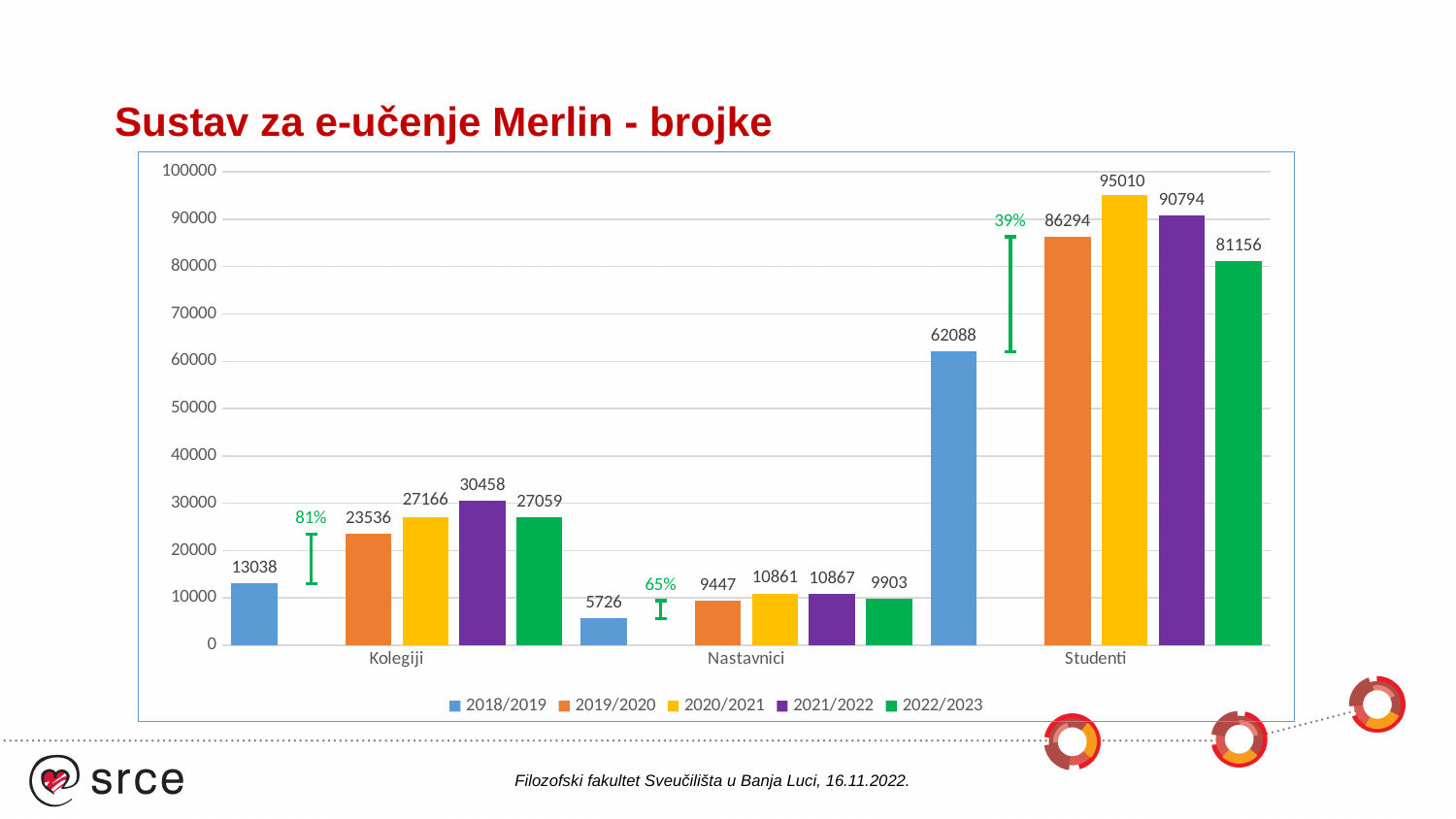
What kind of chart is shown on the slide? bar chart Which series has the highest value for Kolegiji? 2021/2022 Is the 2019/2020 value for Studenti greater or less than 80000? greater Which is larger for Nastavnici: the 2019/2020 value or the 2022/2023 value? 2022/2023 What is the difference between the 2020/2021 and 2018/2019 values for Studenti? 32922 What is the value for Studenti in the 2020/2021 series? 95010 Which series has the lowest value for Studenti? 2018/2019 What is the title of the slide containing the chart? Sustav za e-učenje Merlin - brojke How many categories are shown on the x axis? 3 What is the value for Nastavnici in the 2022/2023 series? 9903 What is the value for Kolegiji in the 2018/2019 series? 13038 How many series does the legend list? 5